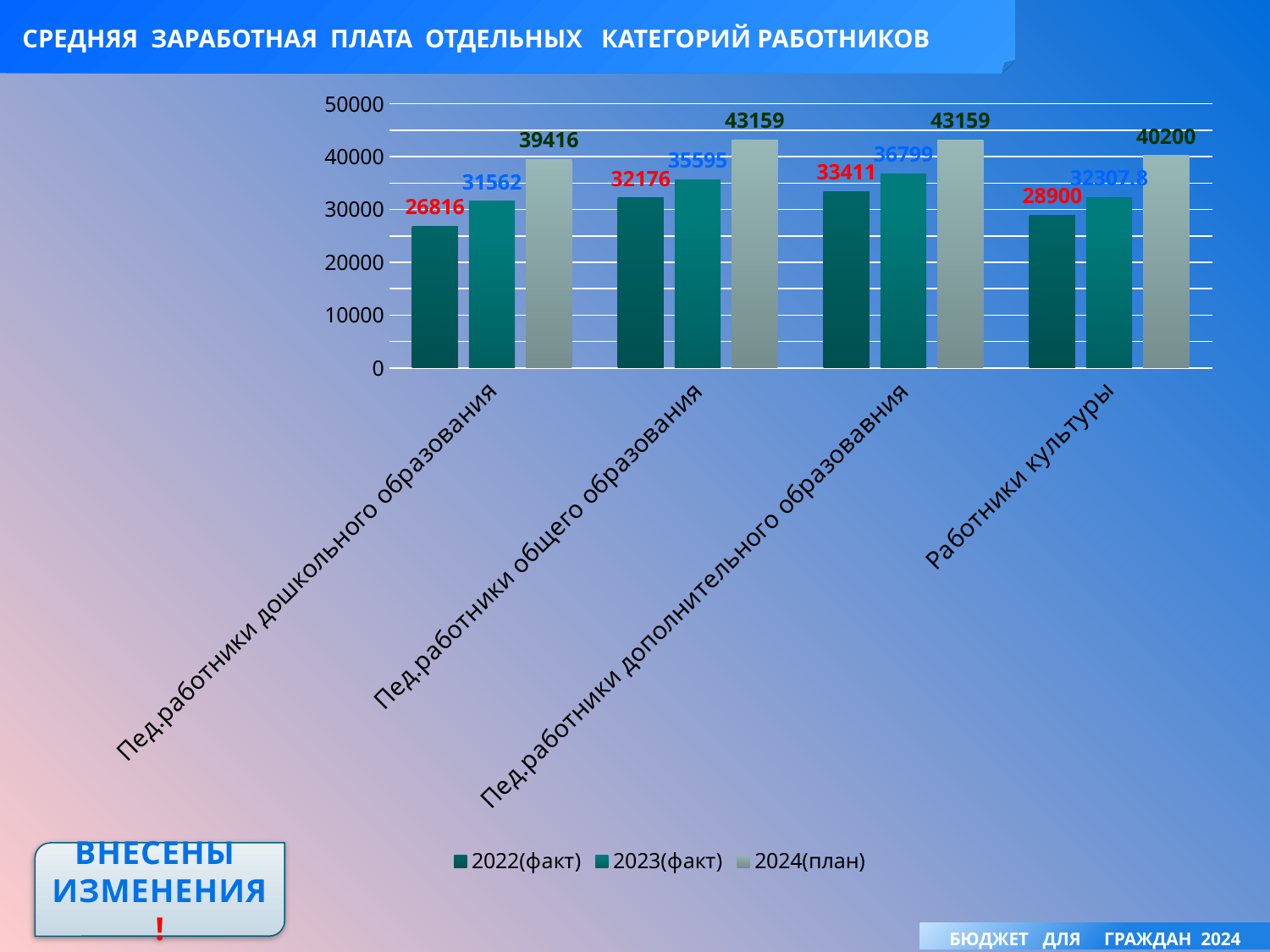
What is the difference between the 2024(план) and 2022(факт) values for Пед.работники общего образования? 10983 What is the 2023(факт) value for Работники культуры? 32307.8 What is the 2023(факт) value for Пед.работники общего образования? 35595 How many categories are shown on the x axis? 4 What kind of chart is shown on the slide? bar chart What is the 2024(план) value for Работники культуры? 40200 Which category has the lowest 2024(план) value? Пед.работники дошкольного образования Which category has the highest 2022(факт) value? Пед.работники дополнительного образовавния What is the 2022(факт) value for Пед.работники дошкольного образования? 26816 How many series does the legend list? 3 Which is larger: the 2023(факт) value for Пед.работники дошкольного образования or for Работники культуры? Работники культуры Is the 2022(факт) value for Работники культуры greater or less than 30000? less